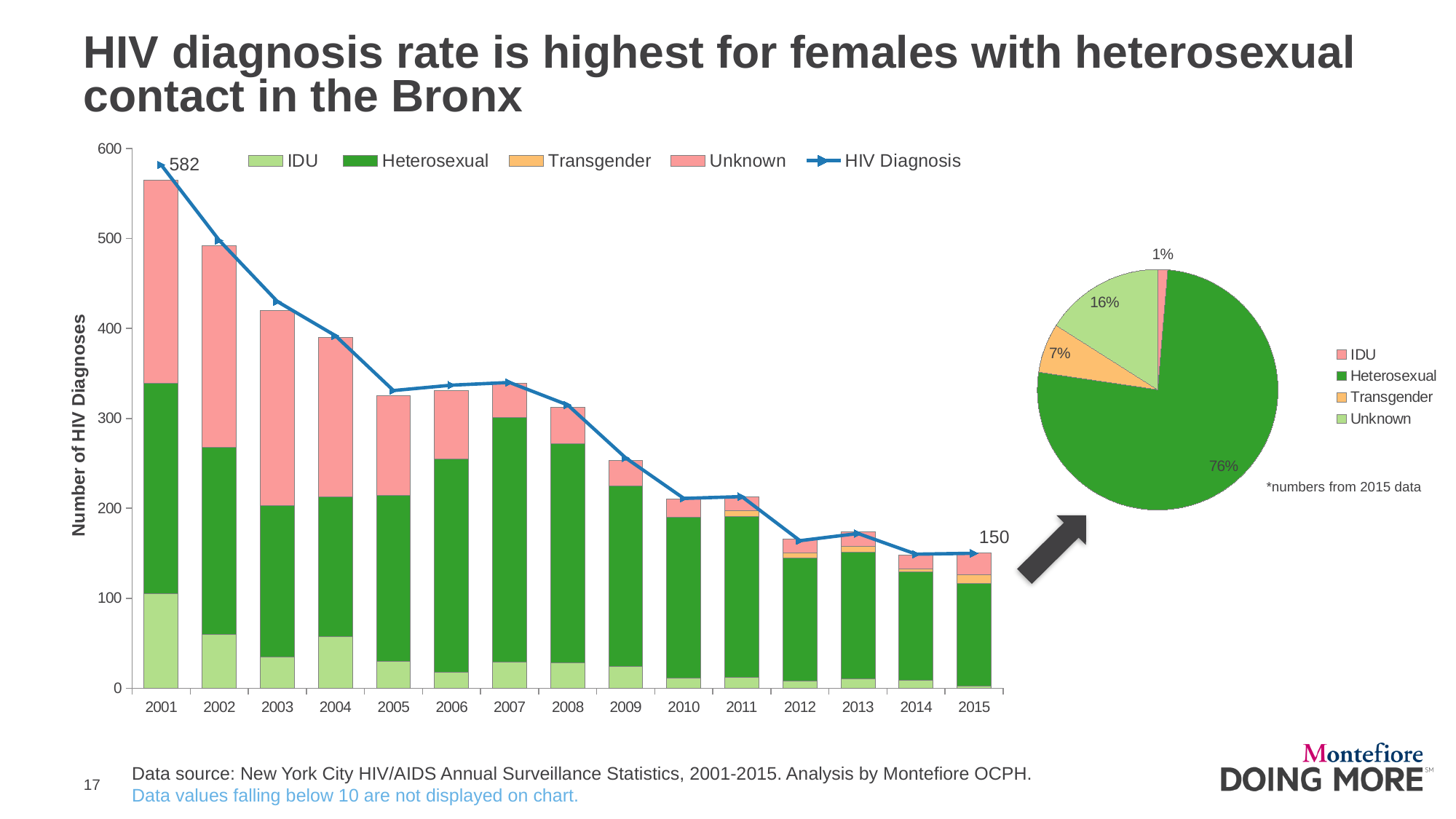
In the bar chart, is the HIV Diagnosis value for 2010 greater or less than 300? less In the bar chart, does the HIV Diagnosis line rise or fall from 2001 to 2015? fall In the bar chart, what is the HIV Diagnosis value shown for 2015? 150 In the bar chart, what is the difference between the HIV Diagnosis values for 2001 and 2015? 432 In the pie chart, what share is Unknown? 16% In the bar chart, what is the HIV Diagnosis value shown for 2001? 582 In the pie chart, what share is Transgender? 7% How many entries does the legend of the bar chart list? 5 In the pie chart, which category has the smallest slice? IDU In the pie chart, what share is Heterosexual? 76% In the pie chart, which category has the largest slice? Heterosexual How many years are shown on the x axis of the bar chart? 15